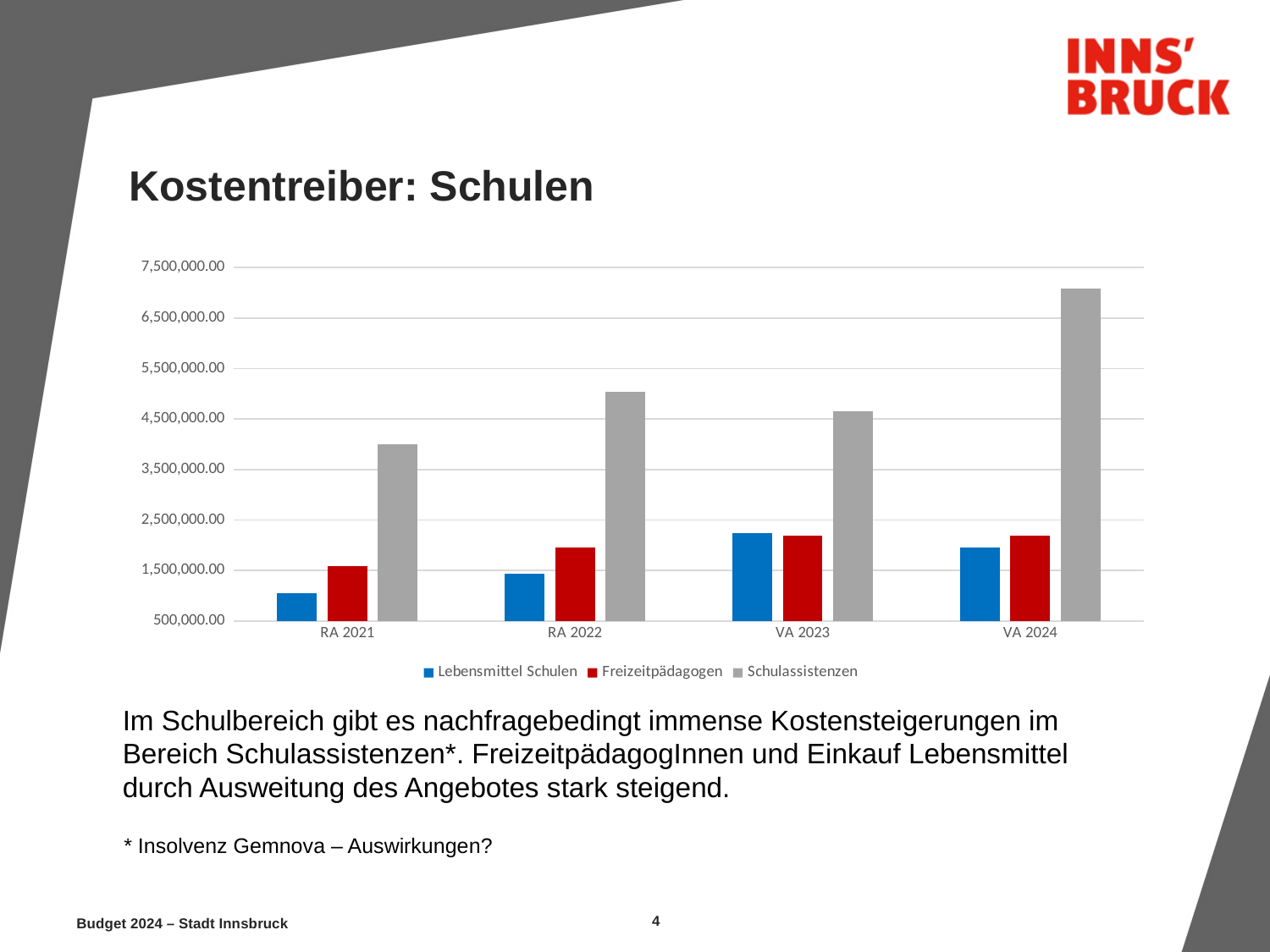
What kind of chart is shown on the slide? bar chart Which is larger for Lebensmittel Schulen: RA 2021 or VA 2023? VA 2023 Is the value for Freizeitpädagogen in RA 2022 greater or less than 1,500,000.00? greater Which is larger in RA 2022: Schulassistenzen or Freizeitpädagogen? Schulassistenzen Is the value for Lebensmittel Schulen in RA 2021 greater or less than 1,500,000.00? less Is the value for Schulassistenzen in RA 2021 greater or less than 4,500,000.00? less How many series does the chart legend list? 3 How many categories are shown on the x axis of the chart? 4 Which colour represents Schulassistenzen in the chart legend? gray In which category is the Lebensmittel Schulen bar lowest? RA 2021 In which category is the Schulassistenzen bar highest? VA 2024